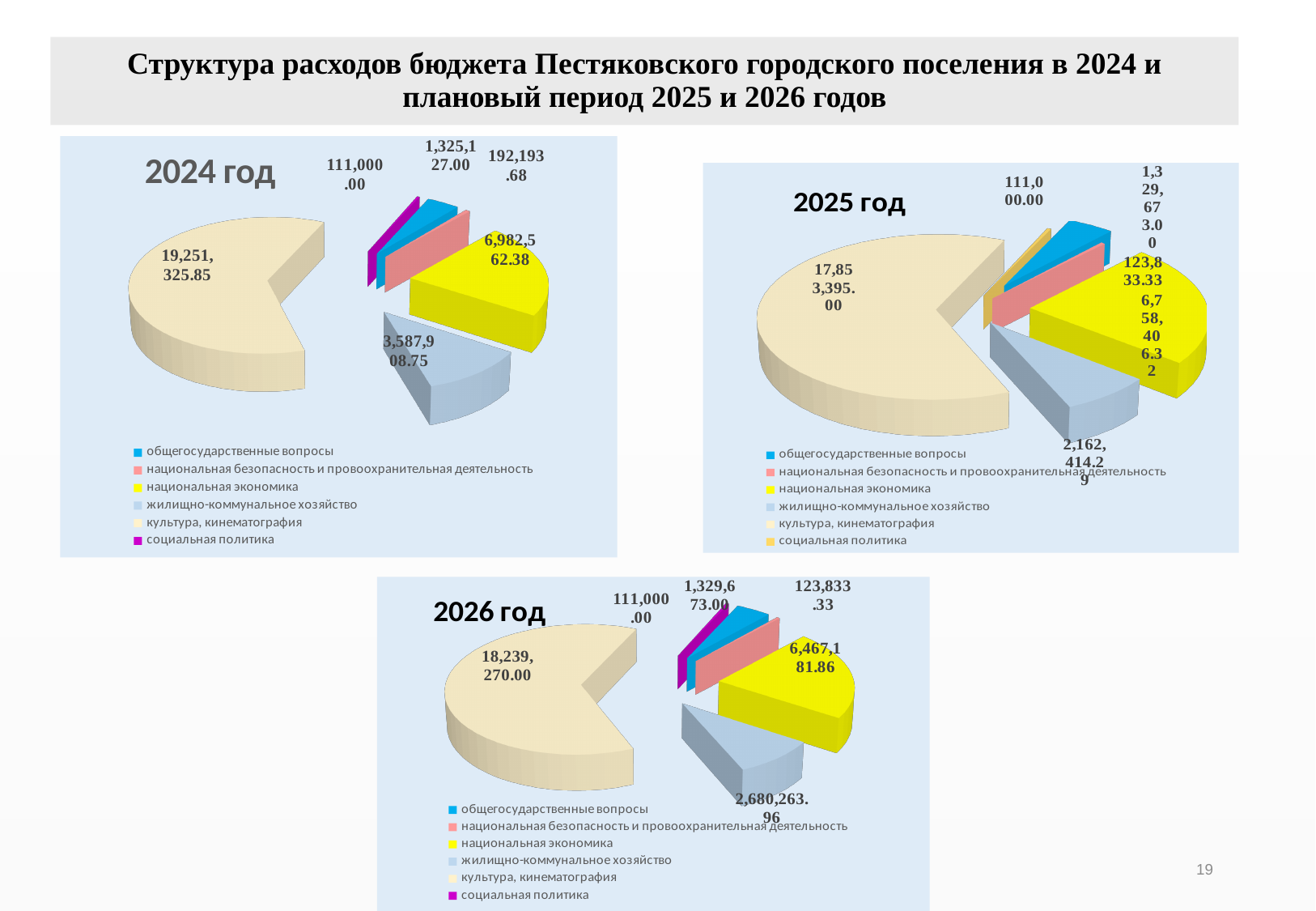
In the "2024 год" chart, what is the value for жилищно-коммунальное хозяйство? 3,587,908.75 What kind of chart is the "2024 год" chart? Pie chart In the "2024 год" chart, what is the difference between национальная экономика and жилищно-коммунальное хозяйство? 3,394,653.63 In the "2024 год" chart, which category has the smallest slice? социальная политика In the "2025 год" chart, what is the value for жилищно-коммунальное хозяйство? 2,162,414.29 In the "2026 год" chart, what is the value for национальная экономика? 6,467,181.86 In the "2024 год" chart, what is the value for культура, кинематография? 19,251,325.85 In the "2025 год" chart, what is the value for культура, кинематография? 17,853,395.00 In the "2026 год" chart, what colour is the slice for социальная политика? Purple In the "2024 год" chart, how many categories does the legend list? 6 In the "2024 год" chart, which category has the largest slice? культура, кинематография In the "2026 год" chart, which is larger: общегосударственные вопросы or национальная безопасность и провоохранительная деятельность? общегосударственные вопросы